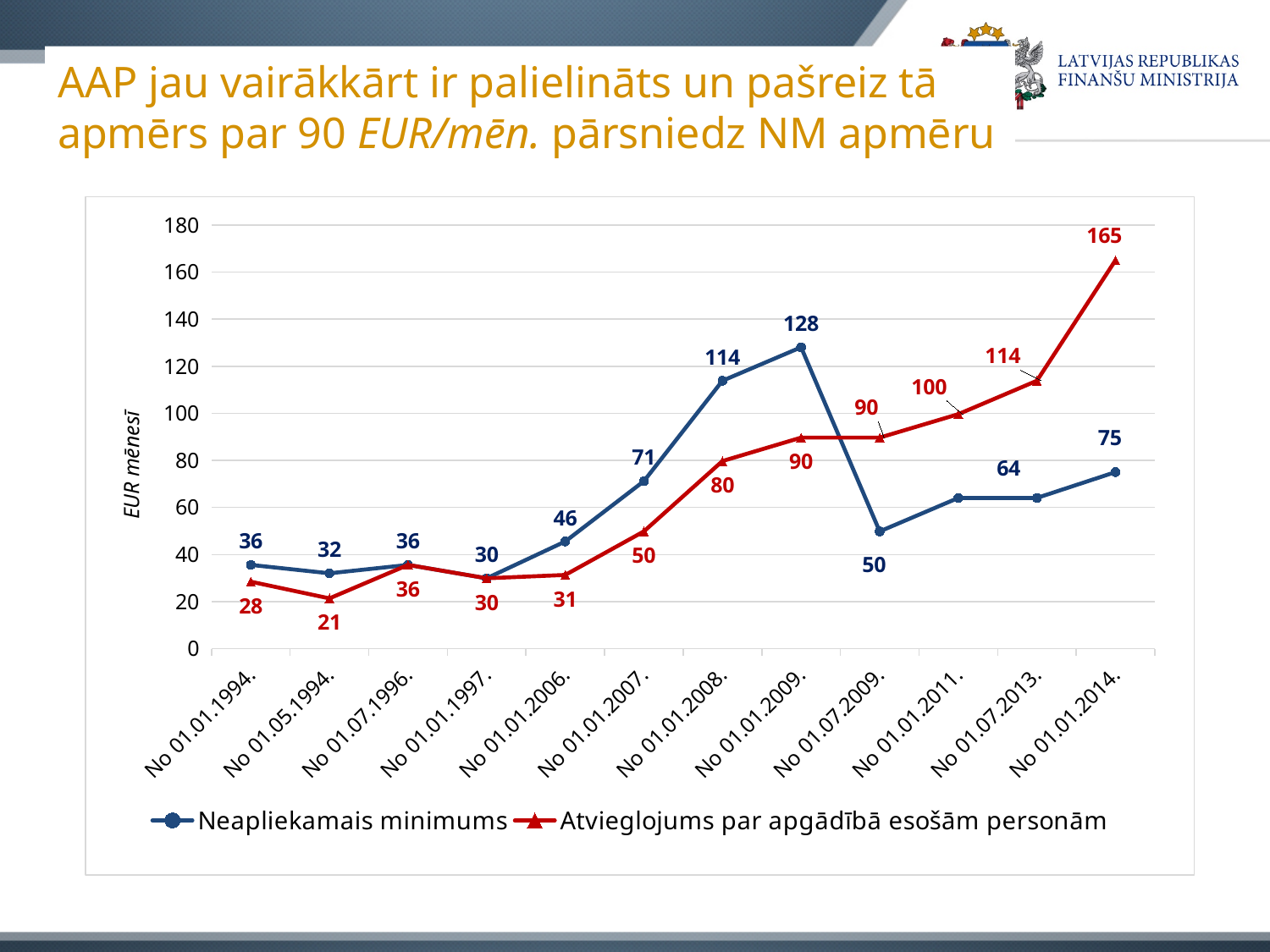
How many series does the legend list? 2 At which date does Neapliekamais minimums reach its highest value? No 01.01.2009. What is the value of Neapliekamais minimums at No 01.01.2009.? 128 Does Atvieglojums par apgādībā esošām personām rise or fall between No 01.07.2009. and No 01.01.2014.? rise What is the value of Atvieglojums par apgādībā esošām personām at No 01.01.2014.? 165 What is the difference between Atvieglojums par apgādībā esošām personām and Neapliekamais minimums at No 01.01.2014.? 90 At which date is Atvieglojums par apgādībā esošām personām lowest? No 01.05.1994. What is the value of Atvieglojums par apgādībā esošām personām at No 01.05.1994.? 21 At No 01.01.2008., which series has the larger value, Neapliekamais minimums or Atvieglojums par apgādībā esošām personām? Neapliekamais minimums What is the label of the y axis? EUR mēnesī What type of chart is shown on the slide? line chart How many dates are shown on the x axis? 12